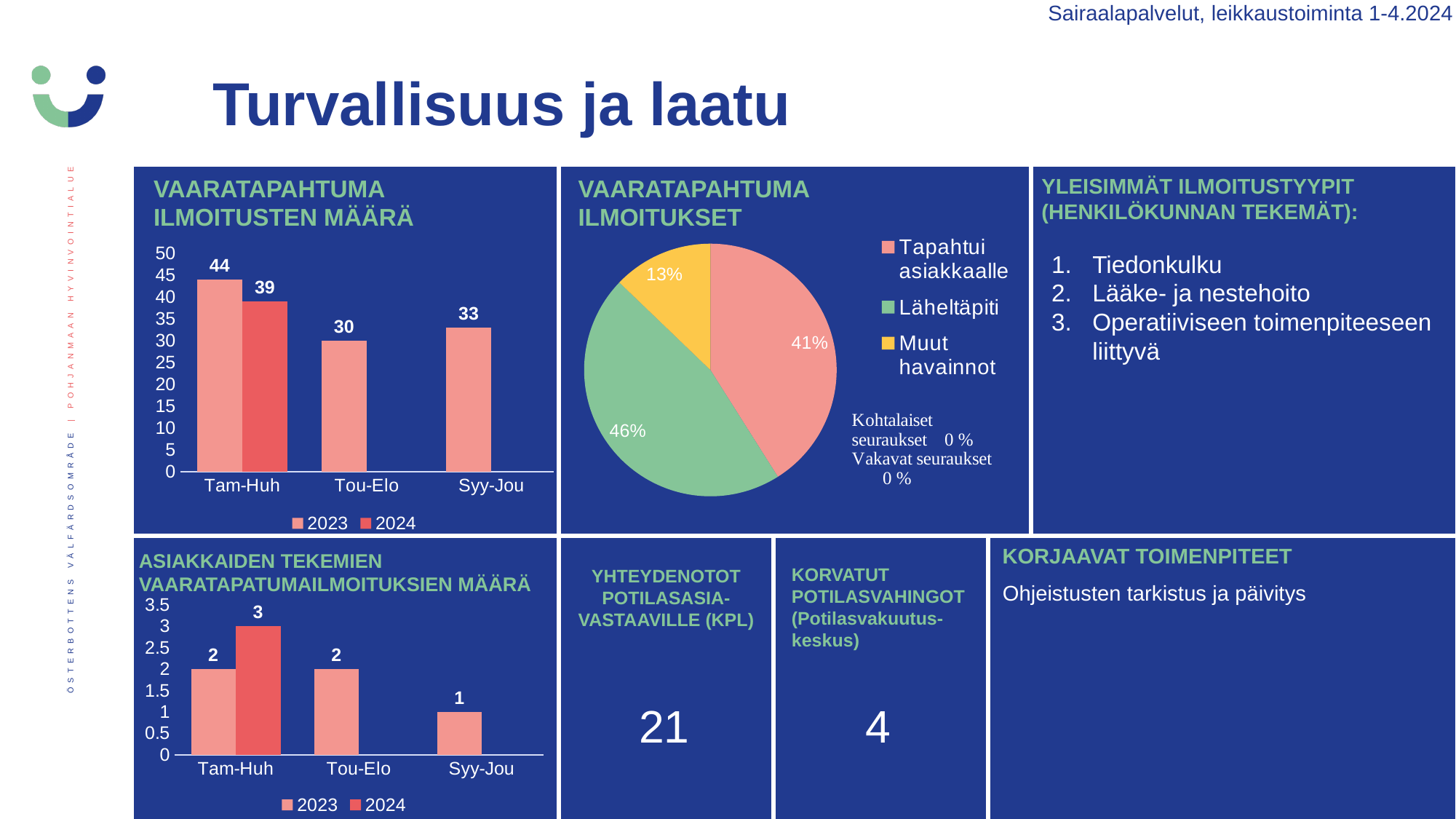
In the ASIAKKAIDEN TEKEMIEN VAARATAPATUMAILMOITUKSIEN MÄÄRÄ chart, what is the 2023 value for Syy-Jou? 1 In the VAARATAPAHTUMA ILMOITUSTEN MÄÄRÄ chart, how many series does the legend list? 2 What kind of chart is VAARATAPAHTUMA ILMOITUKSET? Pie chart In the VAARATAPAHTUMA ILMOITUKSET pie chart, which is larger: Tapahtui asiakkaalle or Läheltäpiti? Läheltäpiti In the VAARATAPAHTUMA ILMOITUSTEN MÄÄRÄ chart, which period has the lowest 2023 value? Tou-Elo In the VAARATAPAHTUMA ILMOITUSTEN MÄÄRÄ chart, what is the 2023 value for Tam-Huh? 44 In the VAARATAPAHTUMA ILMOITUSTEN MÄÄRÄ chart, what is the 2024 value for Tam-Huh? 39 In the ASIAKKAIDEN TEKEMIEN VAARATAPATUMAILMOITUKSIEN MÄÄRÄ chart, how many periods are shown on the x axis? 3 In the VAARATAPAHTUMA ILMOITUSTEN MÄÄRÄ chart, what is the difference between the 2023 and 2024 values for Tam-Huh? 5 In the VAARATAPAHTUMA ILMOITUKSET pie chart, what share is Läheltäpiti? 46% In the ASIAKKAIDEN TEKEMIEN VAARATAPATUMAILMOITUKSIEN MÄÄRÄ chart, what is the 2024 value for Tam-Huh? 3 In the VAARATAPAHTUMA ILMOITUKSET pie chart, which category has the smallest share? Muut havainnot